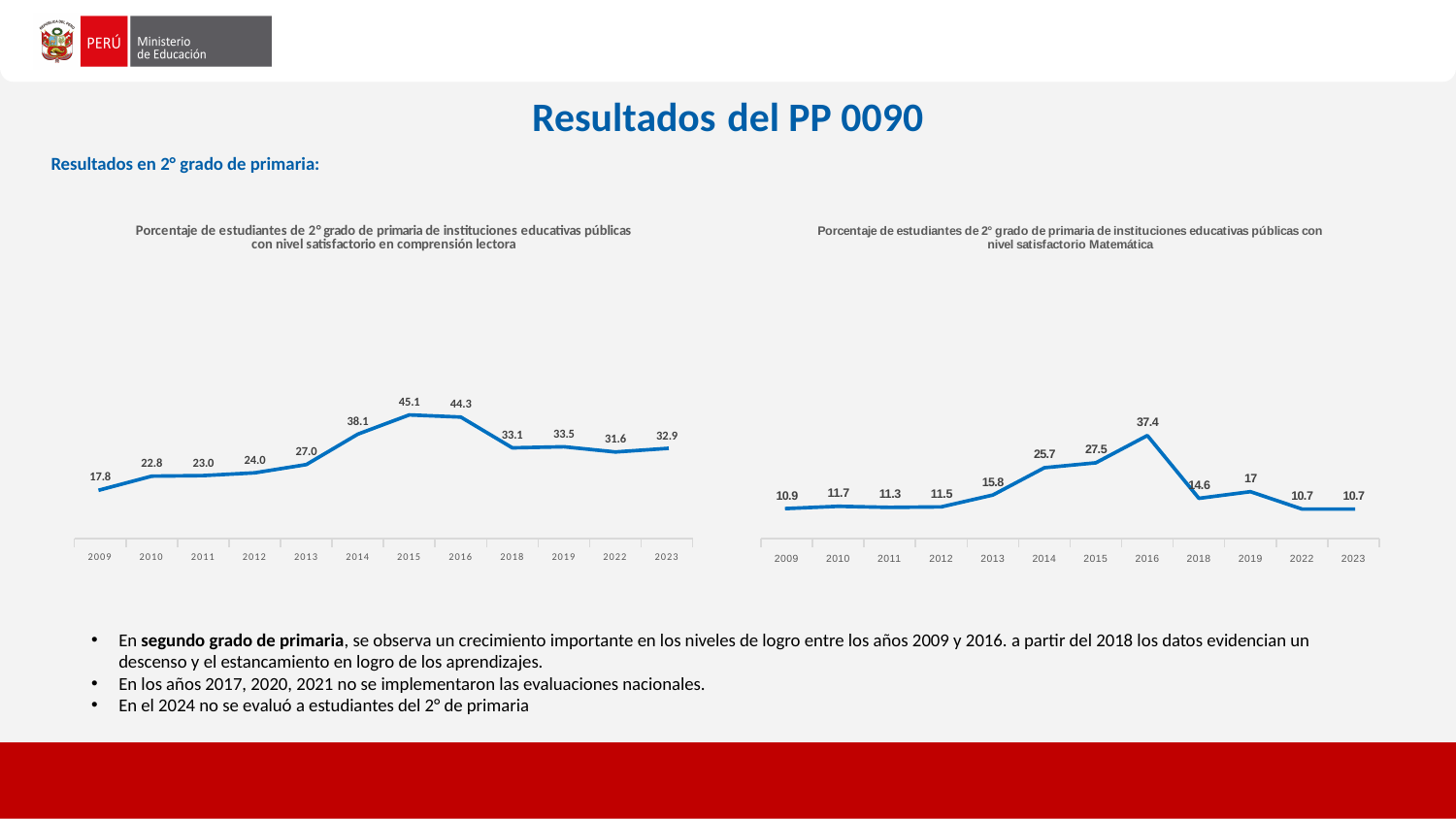
How many years are plotted in the left chart (comprensión lectora)? 12 In the right chart (Matemática), what is the value for 2023? 10.7 In the left chart (comprensión lectora), do the values rise or fall from 2009 to 2015? Rise In the left chart (comprensión lectora), which year has the highest value? 2015 In the left chart (comprensión lectora), what is the value for 2009? 17.8 In the right chart (Matemática), what is the value for 2016? 37.4 In the left chart (comprensión lectora), what is the difference between the 2015 value and the 2009 value? 27.3 In the right chart (Matemática), what is the difference between the 2016 value and the 2018 value? 22.8 What kind of chart is the right chart (Matemática)? Line chart In the left chart (comprensión lectora), what is the value for 2015? 45.1 In the right chart (Matemática), which year has the lowest value? 2022 and 2023 (both 10.7) In the right chart (Matemática), which is larger, the value for 2014 or the value for 2019? 2014